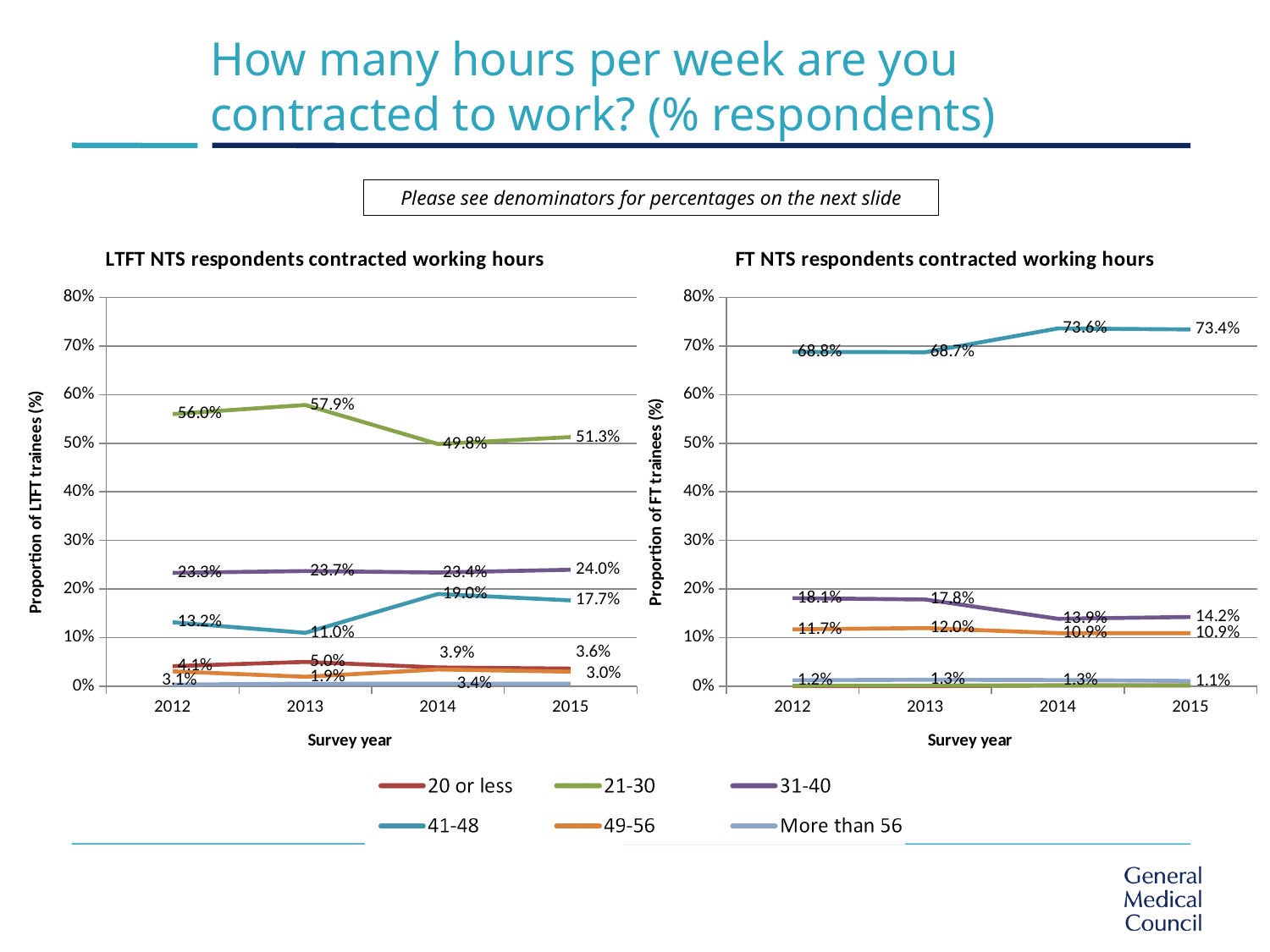
In the LTFT NTS respondents contracted working hours chart, in which survey year is the 21-30 series highest? 2013 In the LTFT NTS respondents contracted working hours chart, what is the difference between the 41-48 values in 2014 and 2013? 8.0 percentage points In the FT NTS respondents contracted working hours chart, does the 41-48 series rise or fall overall from 2012 to 2015? Rises In the FT NTS respondents contracted working hours chart, what is the difference between the 41-48 values in 2015 and 2012? 4.6 percentage points What type of chart is used for the LTFT NTS respondents contracted working hours chart? Line chart How many series does the shared legend list for the two charts? 6 In the FT NTS respondents contracted working hours chart, what is the value for the 41-48 series in 2014? 73.6% In the LTFT NTS respondents contracted working hours chart, which is larger in 2015: the 31-40 series or the 41-48 series? 31-40 In the FT NTS respondents contracted working hours chart, what is the value for the 31-40 series in 2012? 18.1% In the LTFT NTS respondents contracted working hours chart, what is the value for the 21-30 series in 2013? 57.9% How many survey years are shown on the x axis of the FT NTS respondents contracted working hours chart? 4